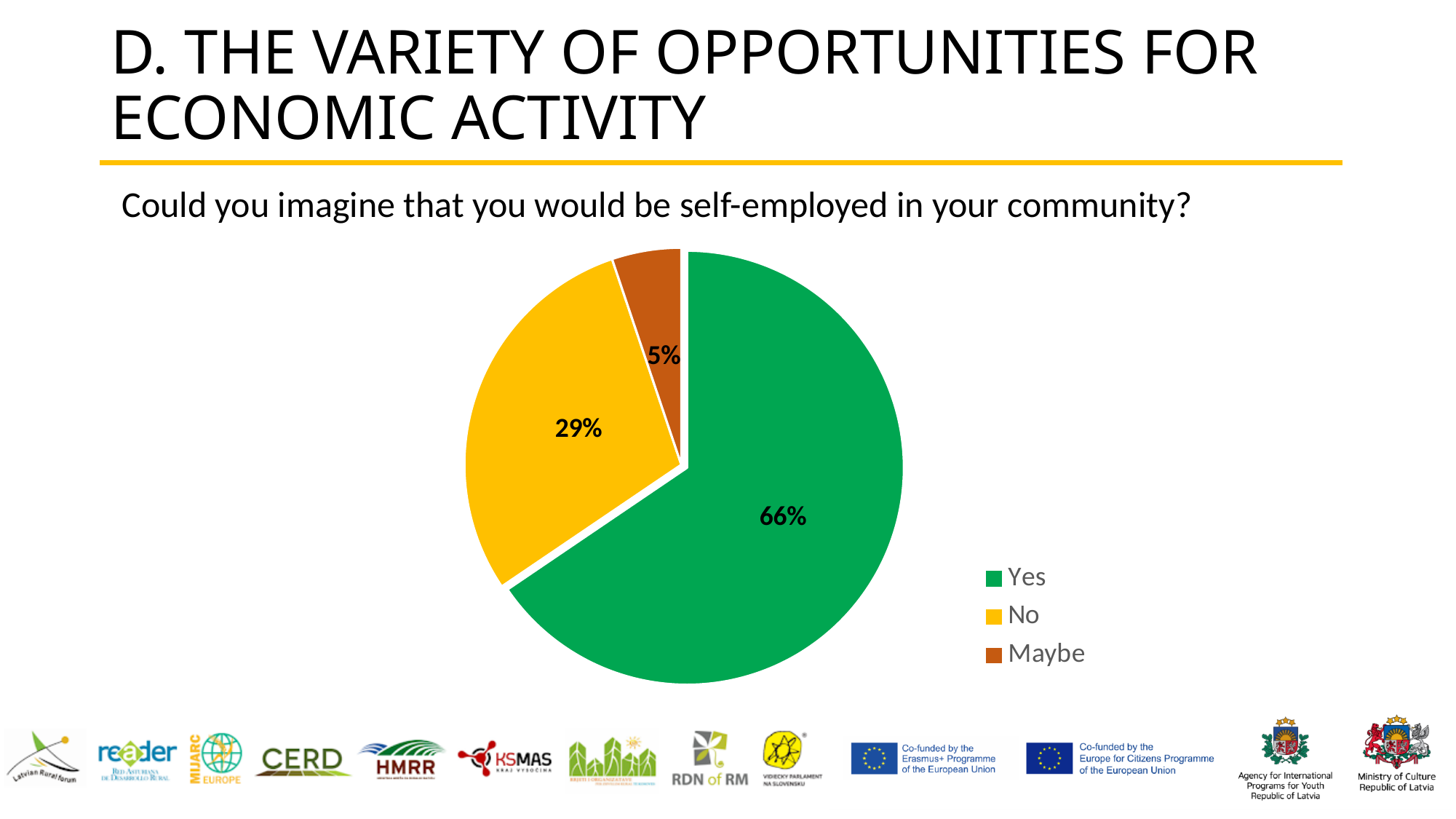
What is the difference in percentage points between the "Yes" and "No" shares? 37 Which is larger, the share for "No" or the share for "Maybe"? No Which response has the largest share of the pie? Yes How many categories does the pie chart show? 3 What percentage of respondents answered "Yes"? 66% Which response has the smallest share of the pie? Maybe What colour is the "Yes" slice in the pie chart? Green What is the difference in percentage points between the "No" and "Maybe" shares? 24 What percentage of respondents answered "No"? 29% What question does the pie chart present responses to? Could you imagine that you would be self-employed in your community? What percentage of respondents answered "Maybe"? 5% What kind of chart is shown on the slide? Pie chart